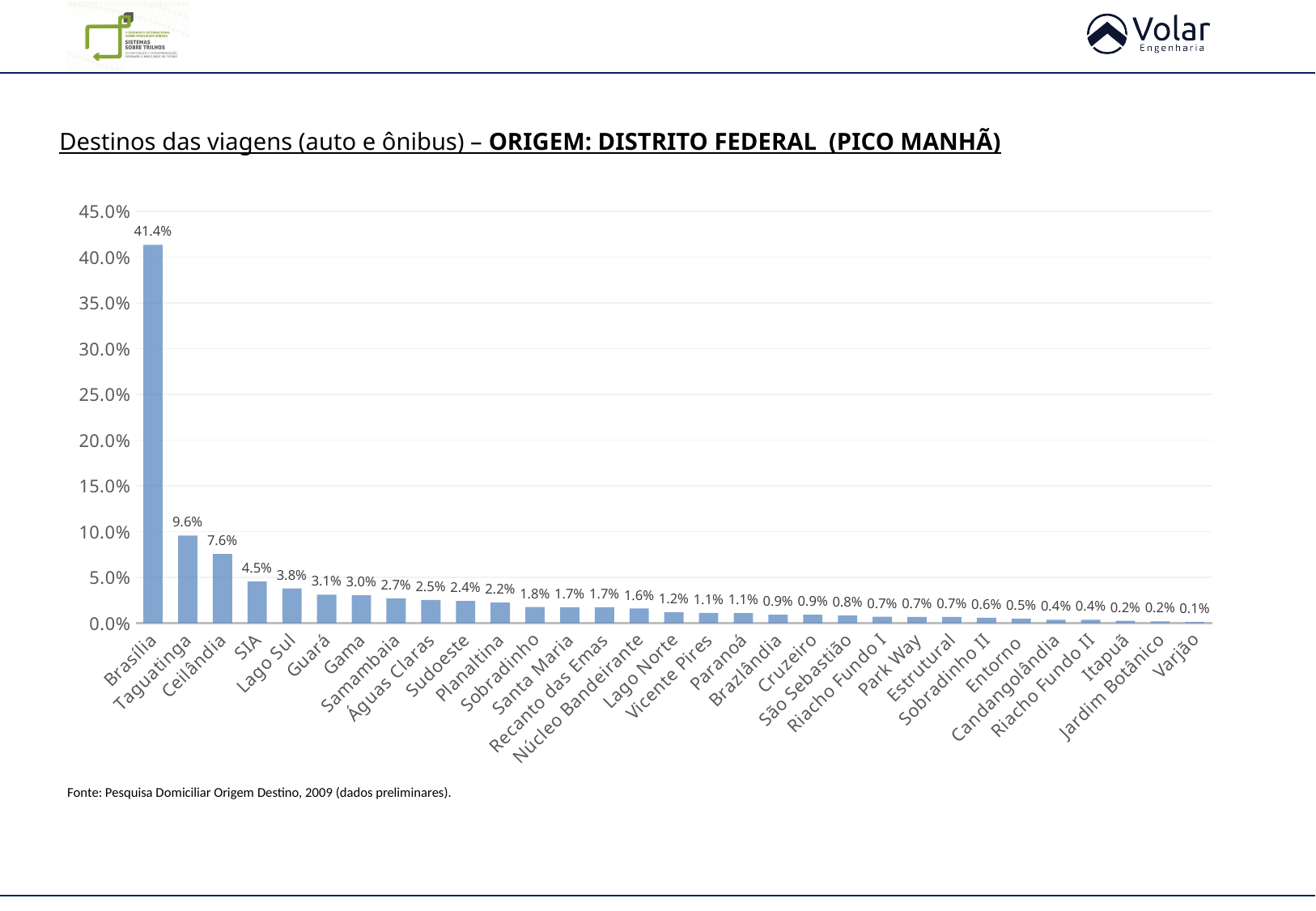
What is the value for Ceilândia? 7.6% What kind of chart is shown on the slide? Bar chart What is the value for Brasília? 41.4% Which is larger, the value for SIA or the value for Lago Sul? SIA How many destinations are shown on the chart? 31 Which destination has the highest value? Brasília What is the value for Taguatinga? 9.6% Which destination has the lowest value? Varjão Is the value for Brasília greater or less than 40.0%? greater What is the value for Varjão? 0.1% What is the value for Águas Claras? 2.5% What is the difference between the values for Brasília and Taguatinga? 31.8%